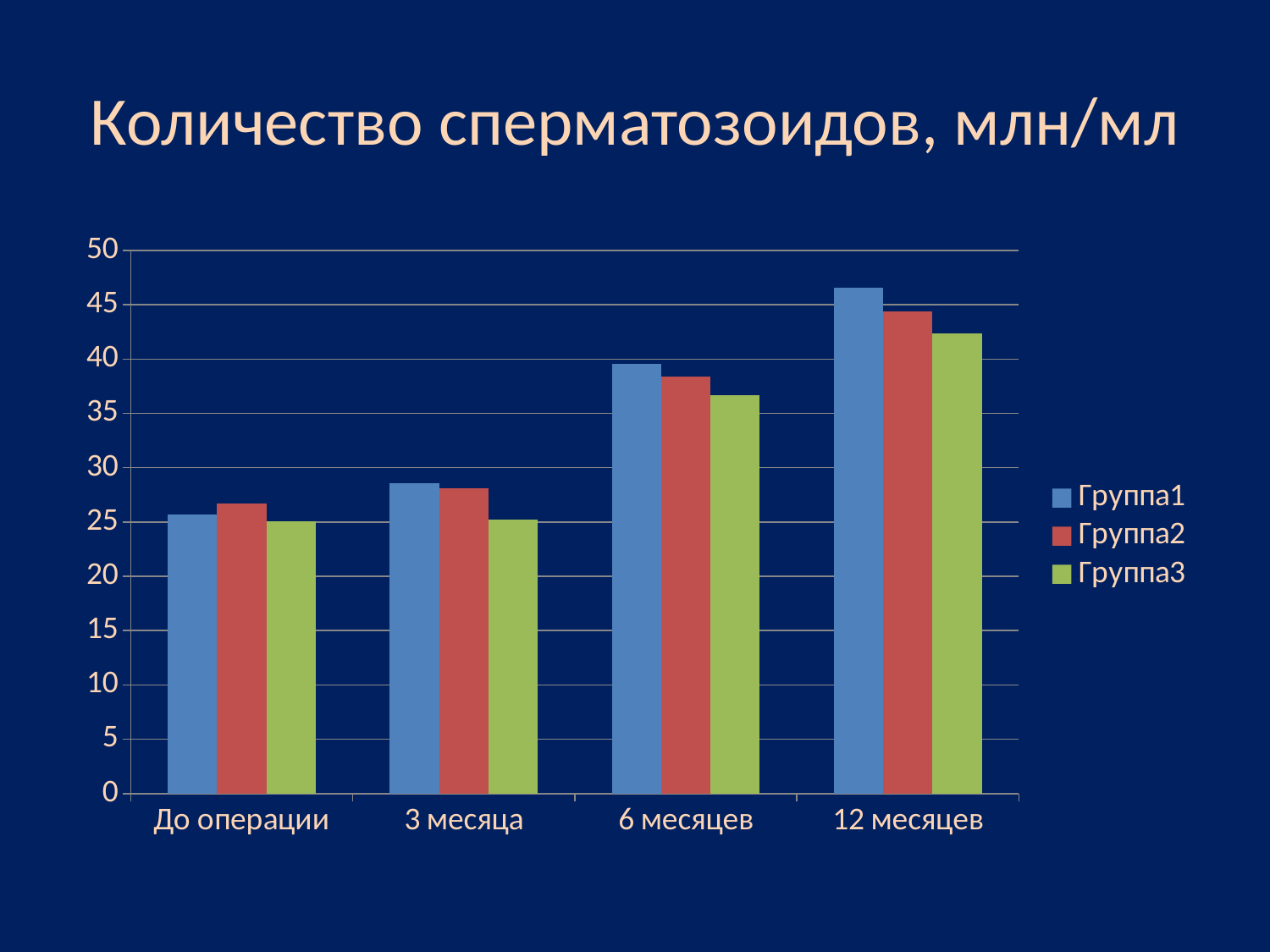
Is the value for Группа3 at 6 месяцев greater or less than 40? less For Группа1, which category has the lowest value? До операции How many series does the legend list? 3 What kind of chart is shown on the slide? bar chart How many categories are shown along the x axis? 4 What is the title of the chart? Количество сперматозоидов, млн/мл At 6 месяцев, which is larger: Группа1 or Группа3? Группа1 Is the value for Группа2 at 3 месяца greater or less than 30? less For Группа1, which category has the highest value? 12 месяцев Is the value for Группа1 at 12 месяцев greater or less than 45? greater At 12 месяцев, which is larger: Группа2 or Группа3? Группа2 Do the values for Группа1 rise or fall from До операции to 12 месяцев? rise